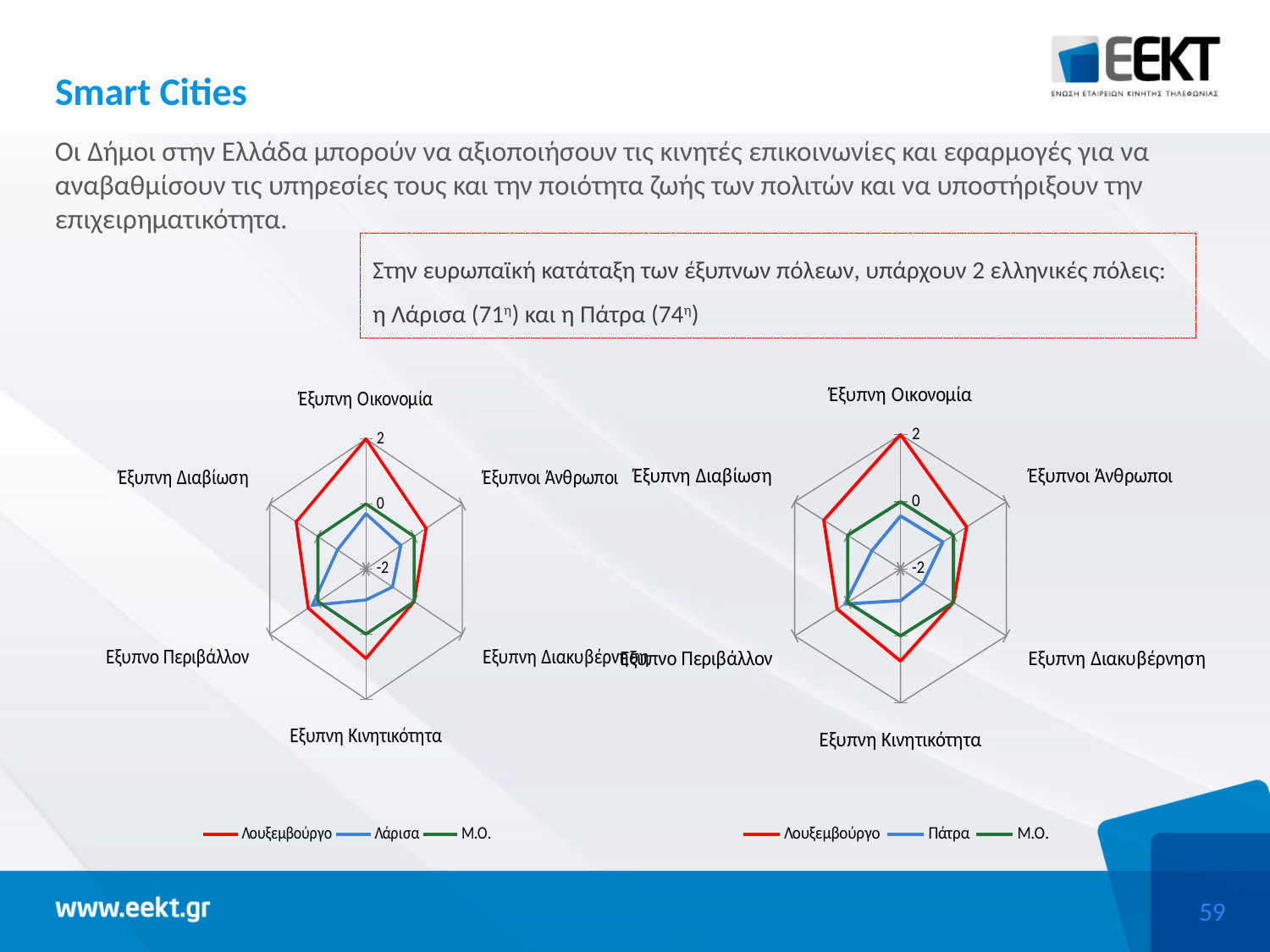
What kind of chart is the left chart on the slide? radar chart In the left chart, is the value of Λάρισα for Έξυπνη Διακυβέρνηση greater or less than 0? less How many series does the legend of the left chart list? 3 In the right chart, is the value of Λουξεμβούργο for Έξυπνη Κινητικότητα greater or less than 0? greater How many axes (categories) does the right chart have? 6 In the right chart, which series is shown in blue? Πάτρα How many series does the legend of the right chart list? 3 In the left chart, is the value of Λουξεμβούργο for Έξυπνη Οικονομία greater or less than 0? greater In the left chart, which series is shown in blue? Λάρισα In the left chart, which is larger for Έξυπνη Οικονομία: Λουξεμβούργο or Λάρισα? Λουξεμβούργο In the right chart, which is larger for Έξυπνοι Άνθρωποι: Λουξεμβούργο or Πάτρα? Λουξεμβούργο